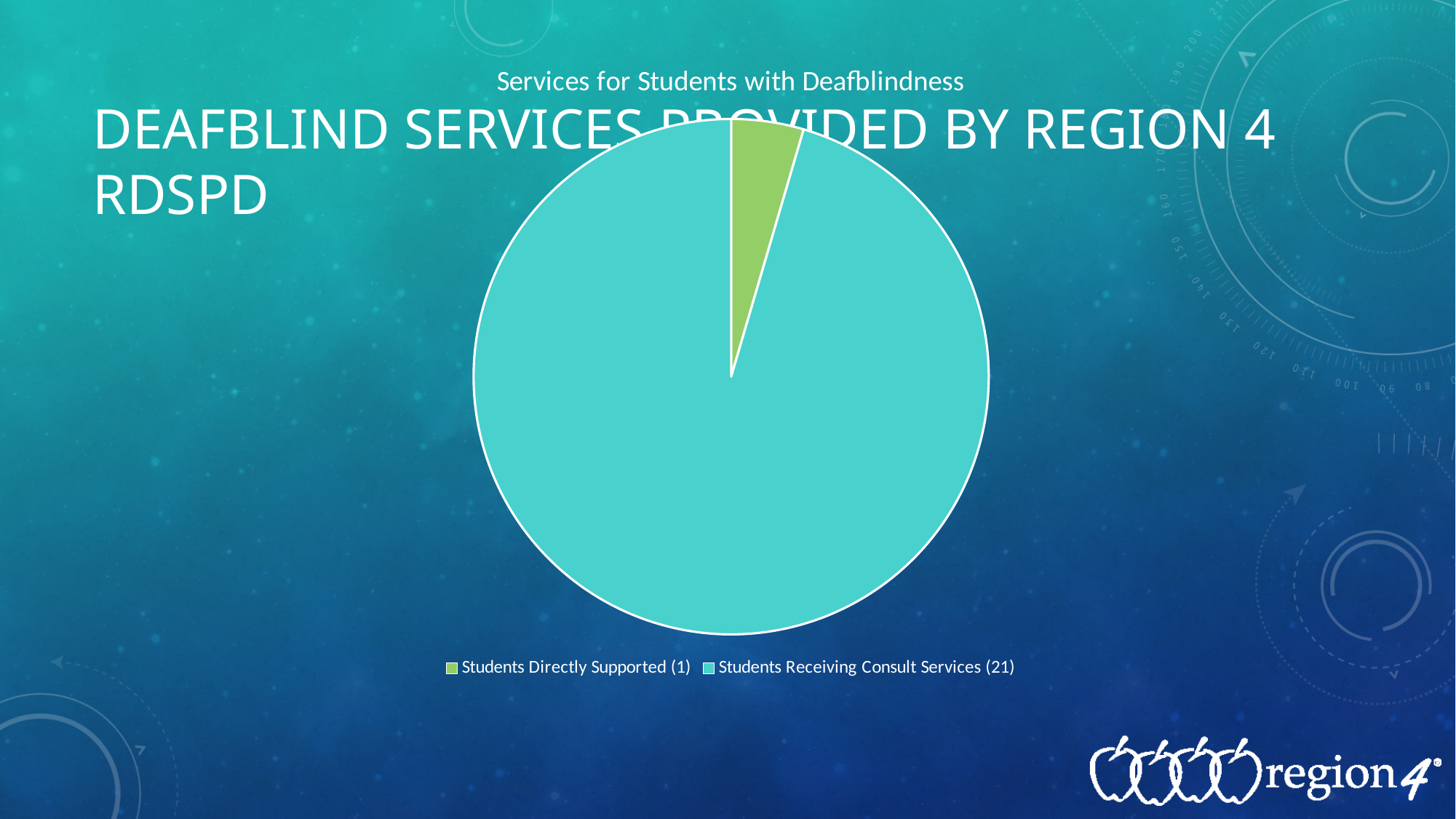
Which category has the smallest slice of the pie? Students Directly Supported How many students are directly supported according to the chart? 1 What is the title of the chart? Services for Students with Deafblindness How many students are receiving consult services according to the chart? 21 Which is larger: the number of students directly supported or the number receiving consult services? Students Receiving Consult Services What kind of chart is shown on the slide? pie chart What is the total number of students represented in the pie chart? 22 What is the difference between the number of students receiving consult services and the number directly supported? 20 Which category has the largest slice of the pie? Students Receiving Consult Services How many slices does the pie chart have? 2 How many entries does the legend list? 2 What colour is the slice for Students Directly Supported? green